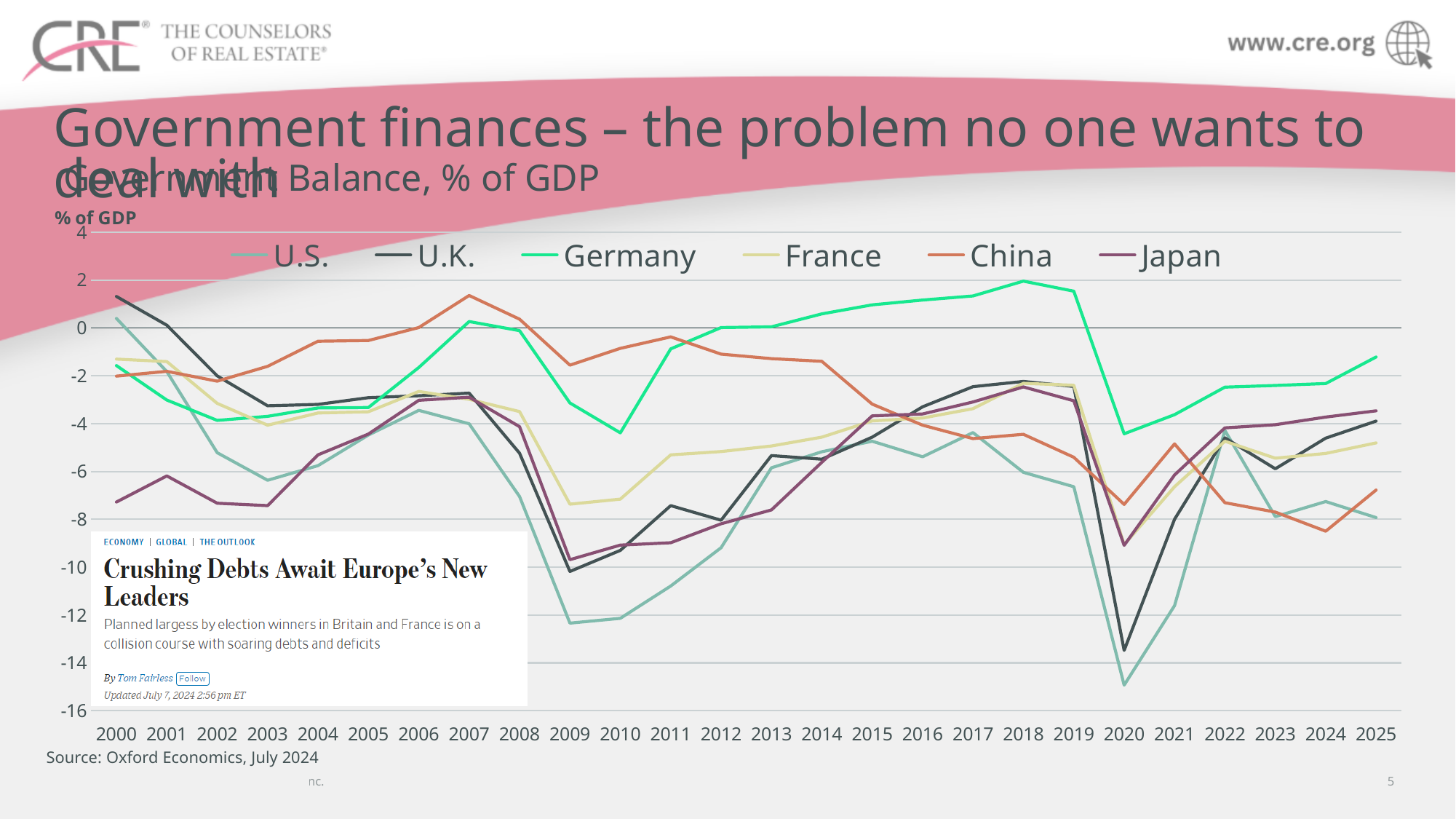
In 2015, which is larger, the value for Germany or the value for France? Germany Which series has the lowest government balance in 2020? U.S. What source is cited below the chart? Oxford Economics, July 2024 Which series has the lowest government balance in 2009? U.S. Is the value for Germany in 2018 greater or less than 0? greater Does the Germany line rise or fall between 2010 and 2018? rise What kind of chart is shown on the slide? line chart How many years are shown along the x axis of the Government Balance chart? 26 Which series has the highest government balance in 2018? Germany Is the value for the U.S. in 2020 greater or less than -14? less Is the value for the U.K. in 2020 greater or less than -12? less How many series does the legend of the Government Balance chart list? 6